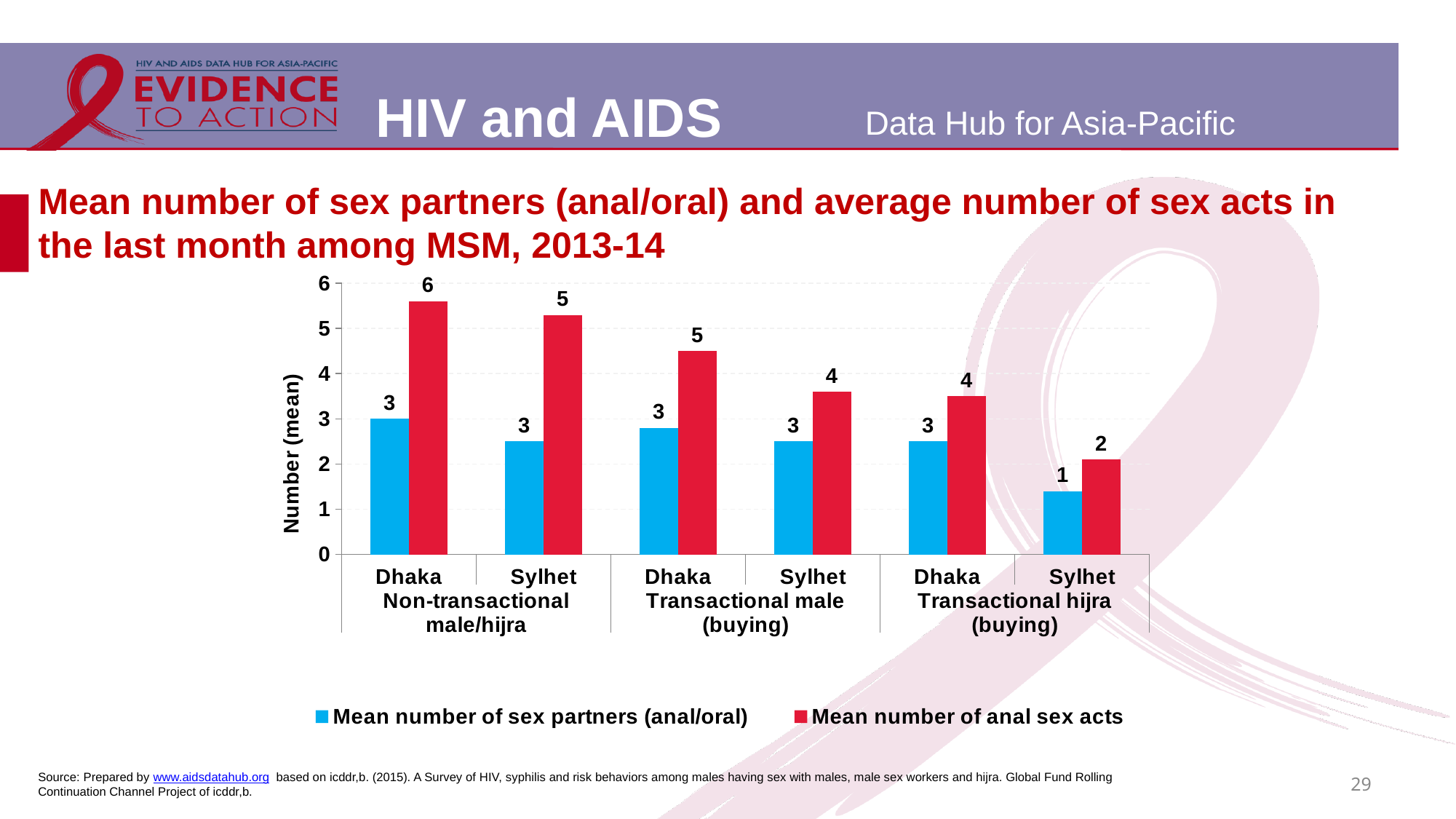
Which city and group has the highest mean number of anal sex acts? Dhaka, Non-transactional male/hijra What kind of chart is shown on the slide? bar chart What colour represents the mean number of anal sex acts in the legend? red What is the mean number of anal sex acts for Dhaka in the Non-transactional male/hijra group? 6 For Dhaka in the Non-transactional male/hijra group, what is the difference between the mean number of anal sex acts and the mean number of sex partners (anal/oral), using the printed labels? 3 How many series does the legend list? 2 How many city/group categories are shown on the x axis? 6 Which is larger: the mean number of anal sex acts for Dhaka or for Sylhet in the Transactional male (buying) group? Dhaka Which city and group has the lowest mean number of sex partners (anal/oral)? Sylhet, Transactional hijra (buying) Is the mean number of anal sex acts for Sylhet in the Transactional hijra (buying) group greater or less than 3? less What is the mean number of anal sex acts for Sylhet in the Transactional male (buying) group? 4 What is the mean number of sex partners (anal/oral) for Sylhet in the Transactional hijra (buying) group? 1